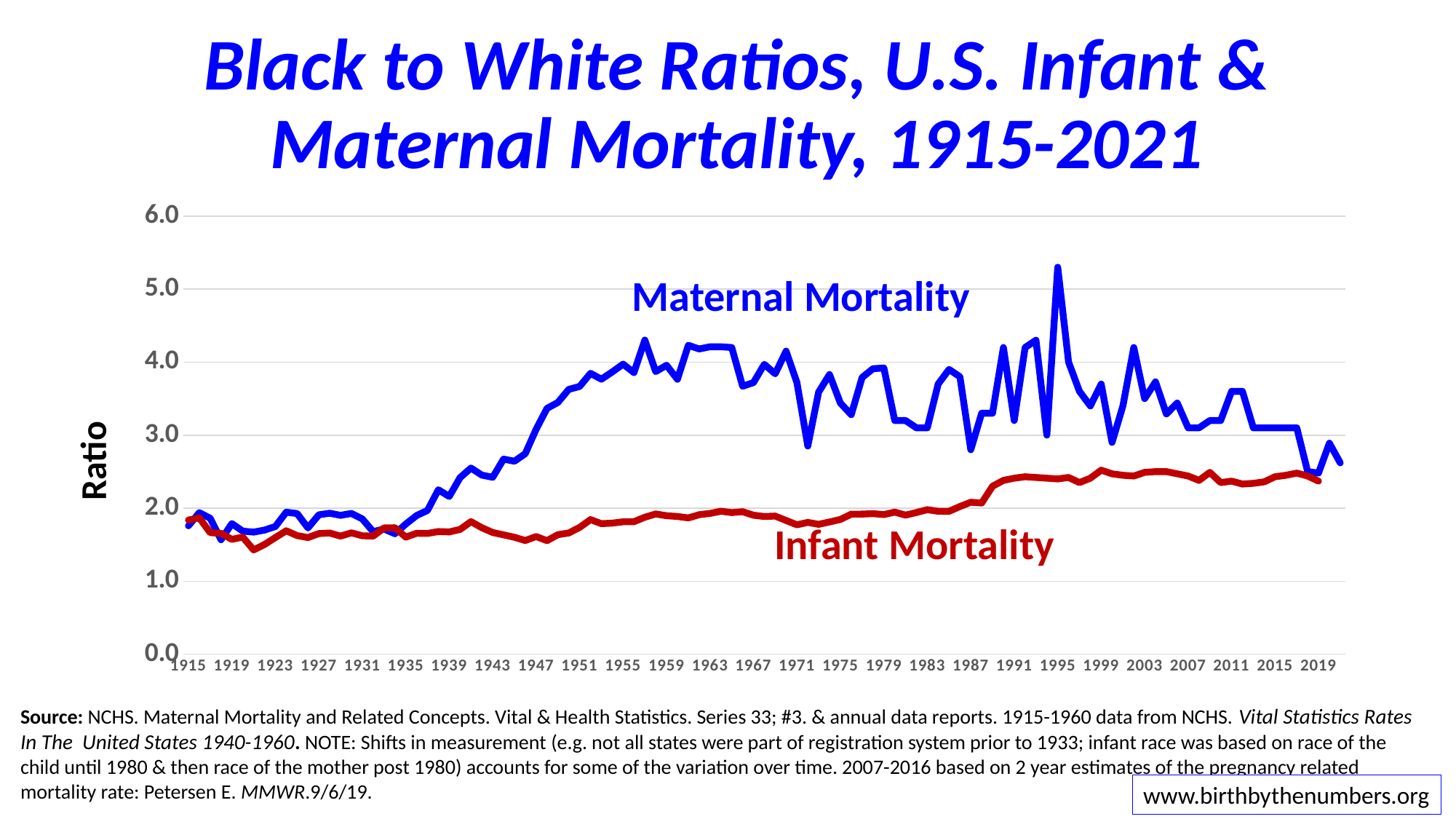
What is the title of the chart? Black to White Ratios, U.S. Infant & Maternal Mortality, 1915-2021 Is the Maternal Mortality ratio in 1915 greater or less than 3.0? less Which series has the higher ratio in 1995, Maternal Mortality or Infant Mortality? Maternal Mortality Which series reaches the highest ratio anywhere on the chart? Maternal Mortality Is the Infant Mortality ratio in 2015 greater or less than 2.0? greater What kind of chart is shown on the slide? line chart Does the Maternal Mortality ratio rise or fall between 1935 and 1955? rise Is the Infant Mortality ratio in 1947 greater or less than 2.0? less How many data series are plotted on the chart? 2 What is the label on the vertical axis? Ratio